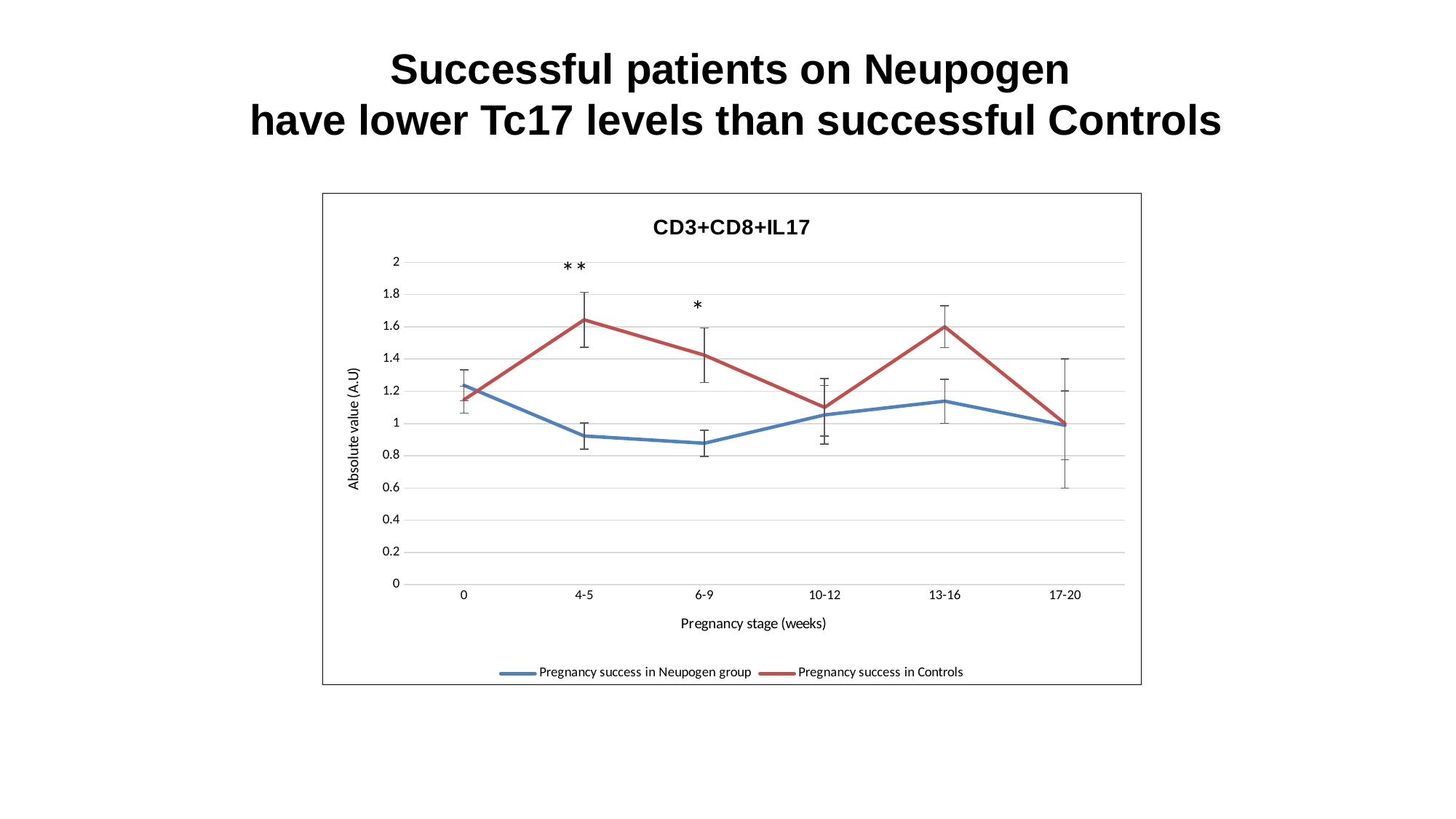
At 6-9 weeks, which series has the larger value, Pregnancy success in Neupogen group or Pregnancy success in Controls? Pregnancy success in Controls How many pregnancy stage categories are shown on the x axis? 6 How many series does the legend list? 2 Does the value for Pregnancy success in Controls rise or fall from 4-5 weeks to 10-12 weeks? fall What kind of chart is shown on the slide? Line chart At 0 weeks, which series has the larger value, Pregnancy success in Neupogen group or Pregnancy success in Controls? Pregnancy success in Neupogen group What is the title of the chart? CD3+CD8+IL17 Is the value for Pregnancy success in Neupogen group at 4-5 weeks greater or less than 1? less What is the label of the y axis? Absolute value (A.U) Is the value for Pregnancy success in Controls at 4-5 weeks greater or less than 1.4? greater Is the value for Pregnancy success in Controls at 13-16 weeks greater or less than 1.4? greater At which pregnancy stage is the value for Pregnancy success in Neupogen group highest? 0